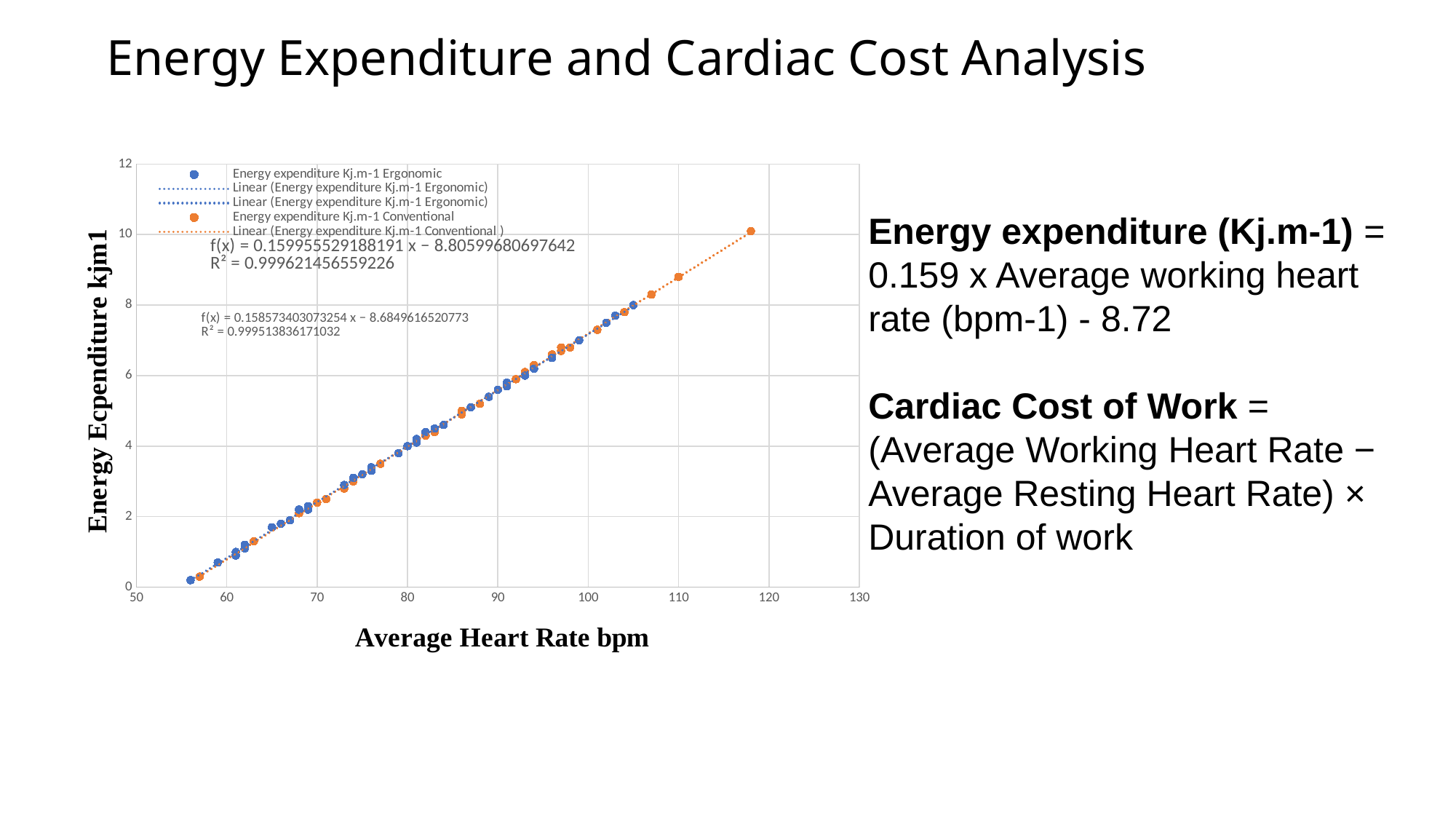
What is the title of the x axis of the chart? Average Heart Rate bpm How many entries does the chart legend list? 5 What kind of chart is shown on the slide? scatter chart Is the energy expenditure value at an average heart rate of 80 bpm greater or less than 6? less Do the energy expenditure values rise or fall as average heart rate increases along the x axis? rise Is the energy expenditure value at an average heart rate of 90 bpm greater or less than 4? greater Which series contains the point with the highest energy expenditure on the chart? Energy expenditure Kj.m-1 Conventional What colour are the points for the Energy expenditure Kj.m-1 Conventional series? orange Is the energy expenditure value at an average heart rate of 100 bpm greater or less than 6? greater